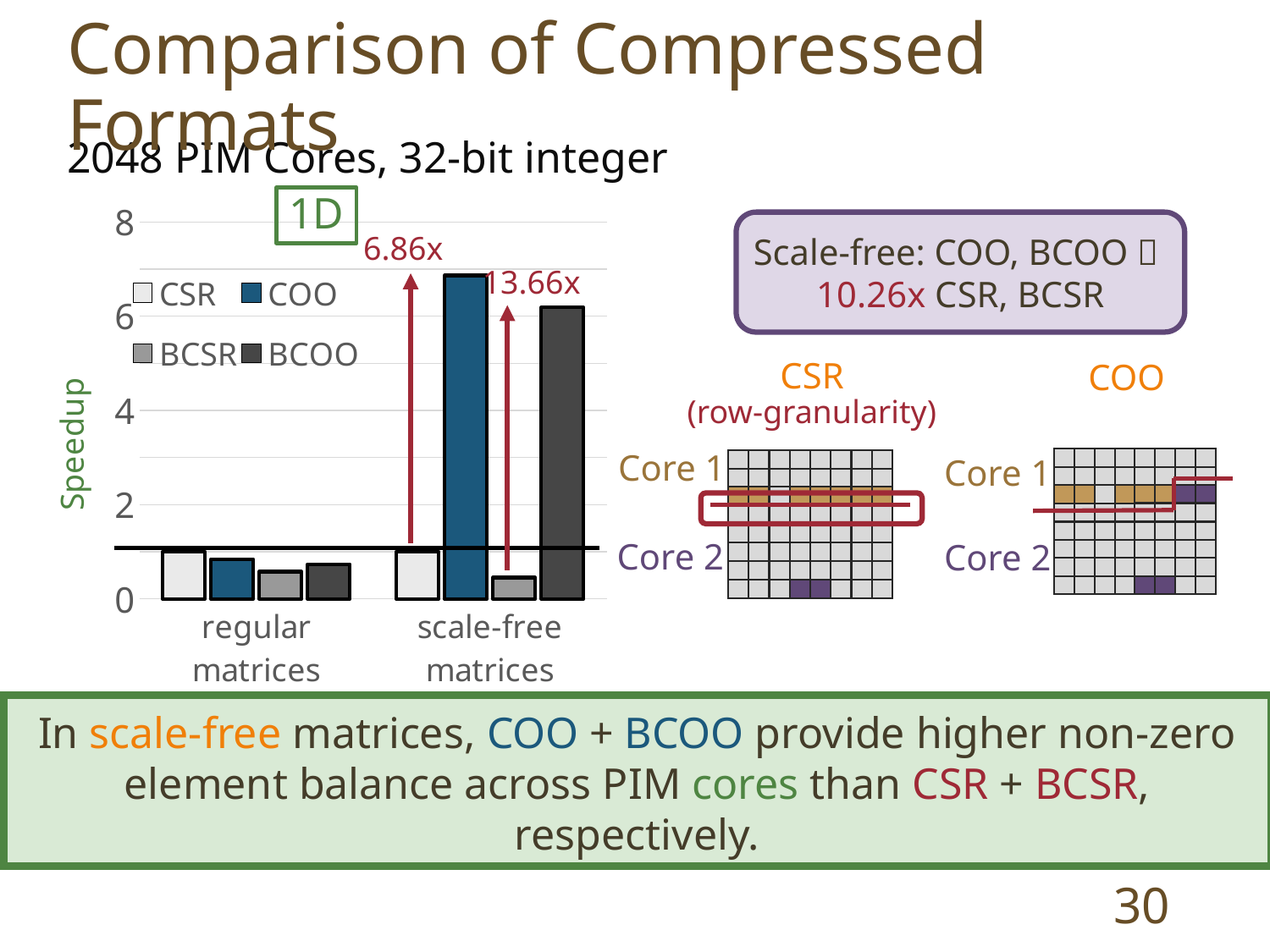
Is the speedup for COO on scale-free matrices greater or less than 6? greater What kind of chart is shown on the slide? bar chart How many series does the chart legend list? 4 What is the label on the y axis of the chart? Speedup How many categories are shown on the x axis of the chart? 2 For scale-free matrices, which is larger: the speedup of COO or of BCOO? COO Does the speedup for COO rise or fall from regular matrices to scale-free matrices? rise Which series has the lowest speedup for scale-free matrices? BCSR Which series has the highest speedup for scale-free matrices? COO What are the four series listed in the chart legend? CSR, COO, BCSR, BCOO Is the speedup for BCSR on scale-free matrices greater or less than 2? less Is the speedup for BCOO on scale-free matrices greater or less than 4? greater